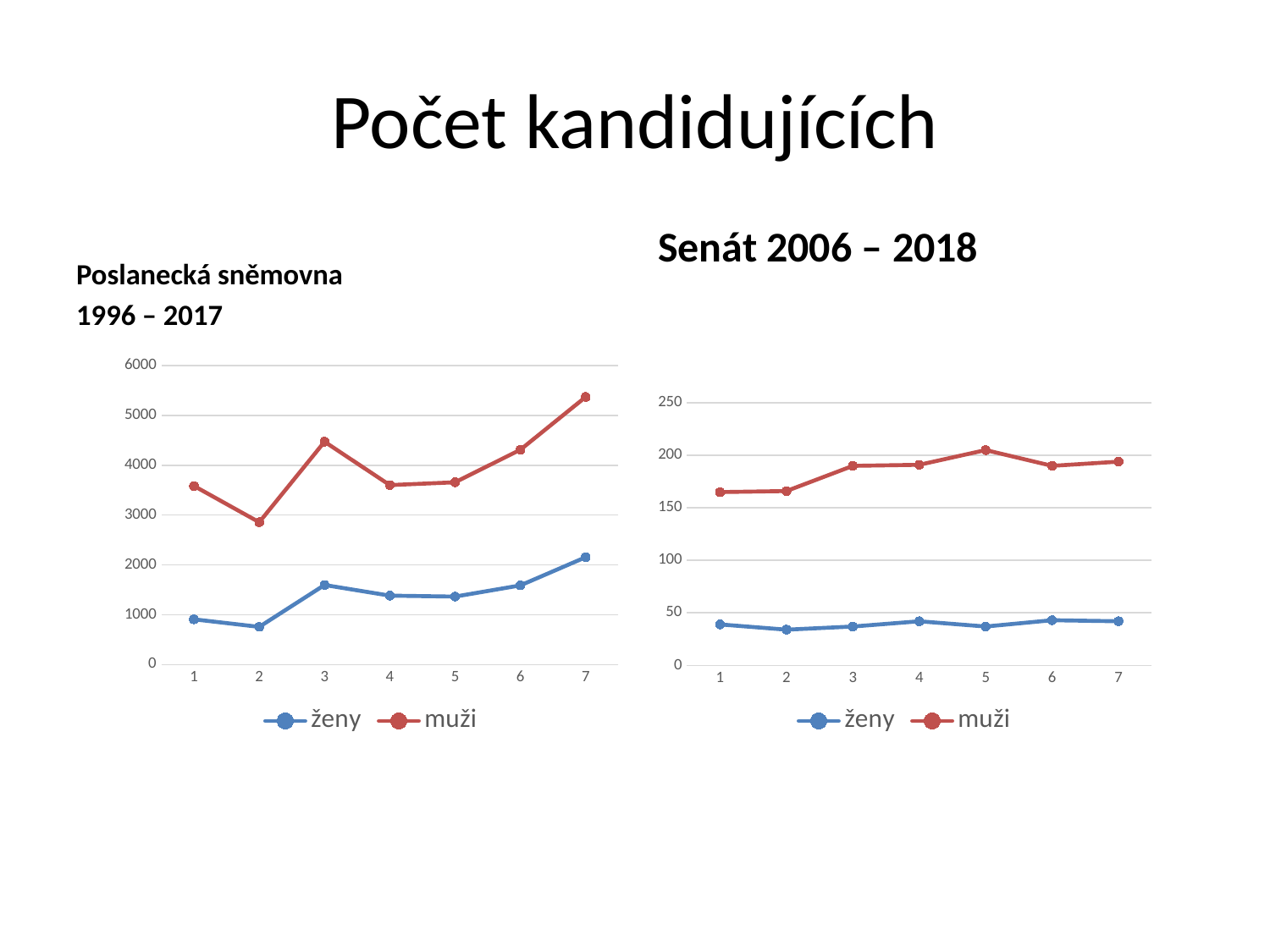
How many points are plotted along the x axis for each series in the Poslanecká sněmovna 1996 – 2017 chart? 7 How many series does the legend of the Senát 2006 – 2018 chart list? 2 In the Poslanecká sněmovna 1996 – 2017 chart, at which x-axis point is the ženy series lowest? 2 In the Senát 2006 – 2018 chart, at which x-axis point is the muži series highest? 5 In the Poslanecká sněmovna 1996 – 2017 chart, is the muži value at point 7 greater or less than 5000? greater What kind of chart is the Poslanecká sněmovna 1996 – 2017 chart? line chart In the Poslanecká sněmovna 1996 – 2017 chart, at which x-axis point is the muži series lowest? 2 In the Poslanecká sněmovna 1996 – 2017 chart, at which x-axis point is the muži series highest? 7 In the Senát 2006 – 2018 chart, which series has higher values, ženy or muži? muži In the Poslanecká sněmovna 1996 – 2017 chart, does the ženy series rise or fall from point 5 to point 7? rise